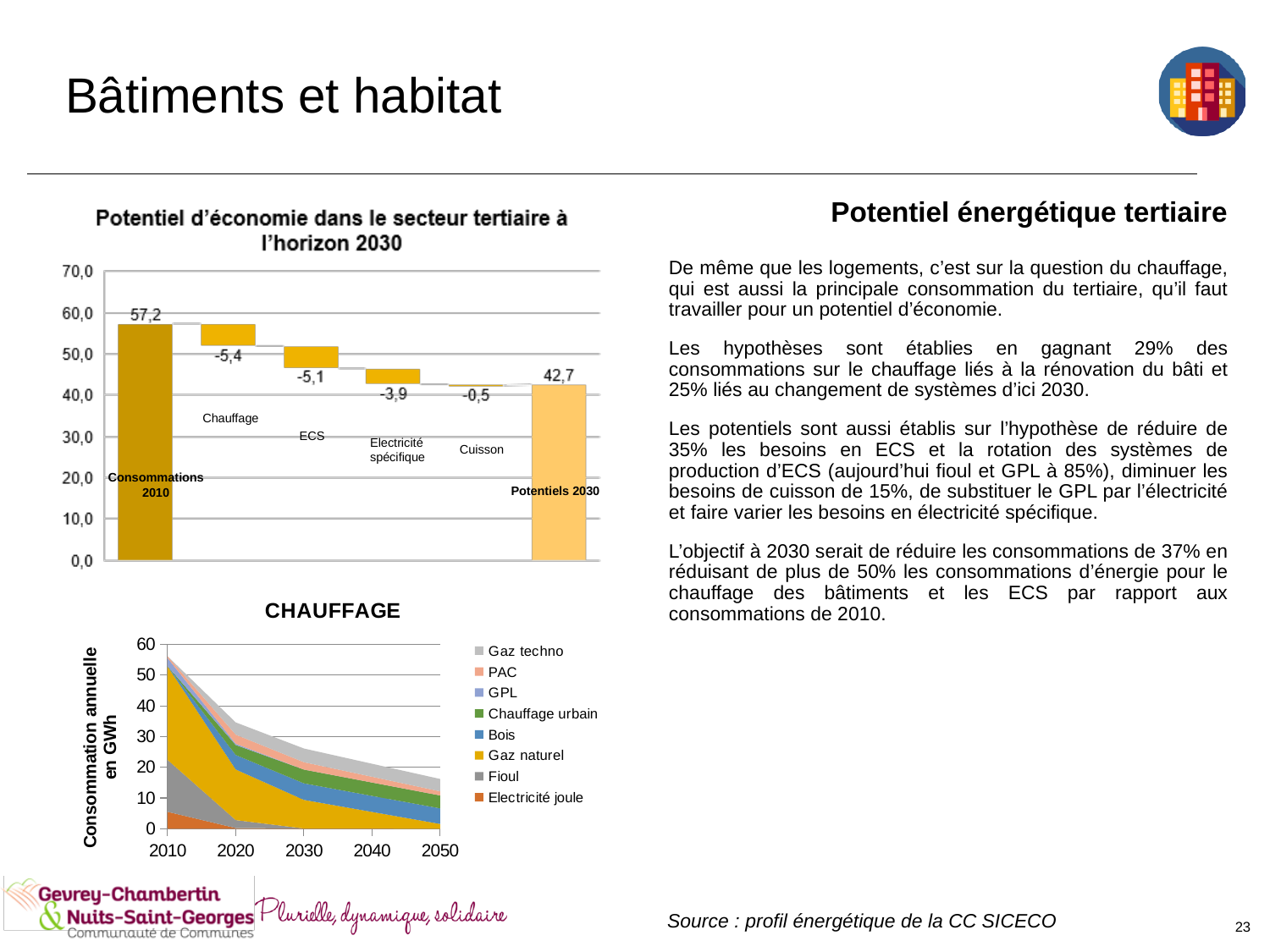
How many series does the legend of the CHAUFFAGE chart list? 8 In the chart 'Potentiel d'économie dans le secteur tertiaire à l'horizon 2030', is the saving for ECS larger or smaller than the saving for Electricité spécifique? larger In the chart 'Potentiel d'économie dans le secteur tertiaire à l'horizon 2030', what is the value shown for Chauffage? -5,4 In the CHAUFFAGE chart, does total consumption rise or fall from 2010 to 2050? fall In the chart 'Potentiel d'économie dans le secteur tertiaire à l'horizon 2030', which reduction step has the largest saving? Chauffage In the chart 'Potentiel d'économie dans le secteur tertiaire à l'horizon 2030', which reduction step has the smallest saving? Cuisson In the chart 'Potentiel d'économie dans le secteur tertiaire à l'horizon 2030', what is the value for Consommations 2010? 57,2 In the chart 'Potentiel d'économie dans le secteur tertiaire à l'horizon 2030', what is the value for Potentiels 2030? 42,7 What is the y-axis label of the CHAUFFAGE chart? Consommation annuelle en GWh In the chart 'Potentiel d'économie dans le secteur tertiaire à l'horizon 2030', what is the difference between Consommations 2010 and Potentiels 2030? 14,5 In the chart 'Potentiel d'économie dans le secteur tertiaire à l'horizon 2030', what is the value shown for Cuisson? -0,5 How many years are shown on the x axis of the CHAUFFAGE chart? 5